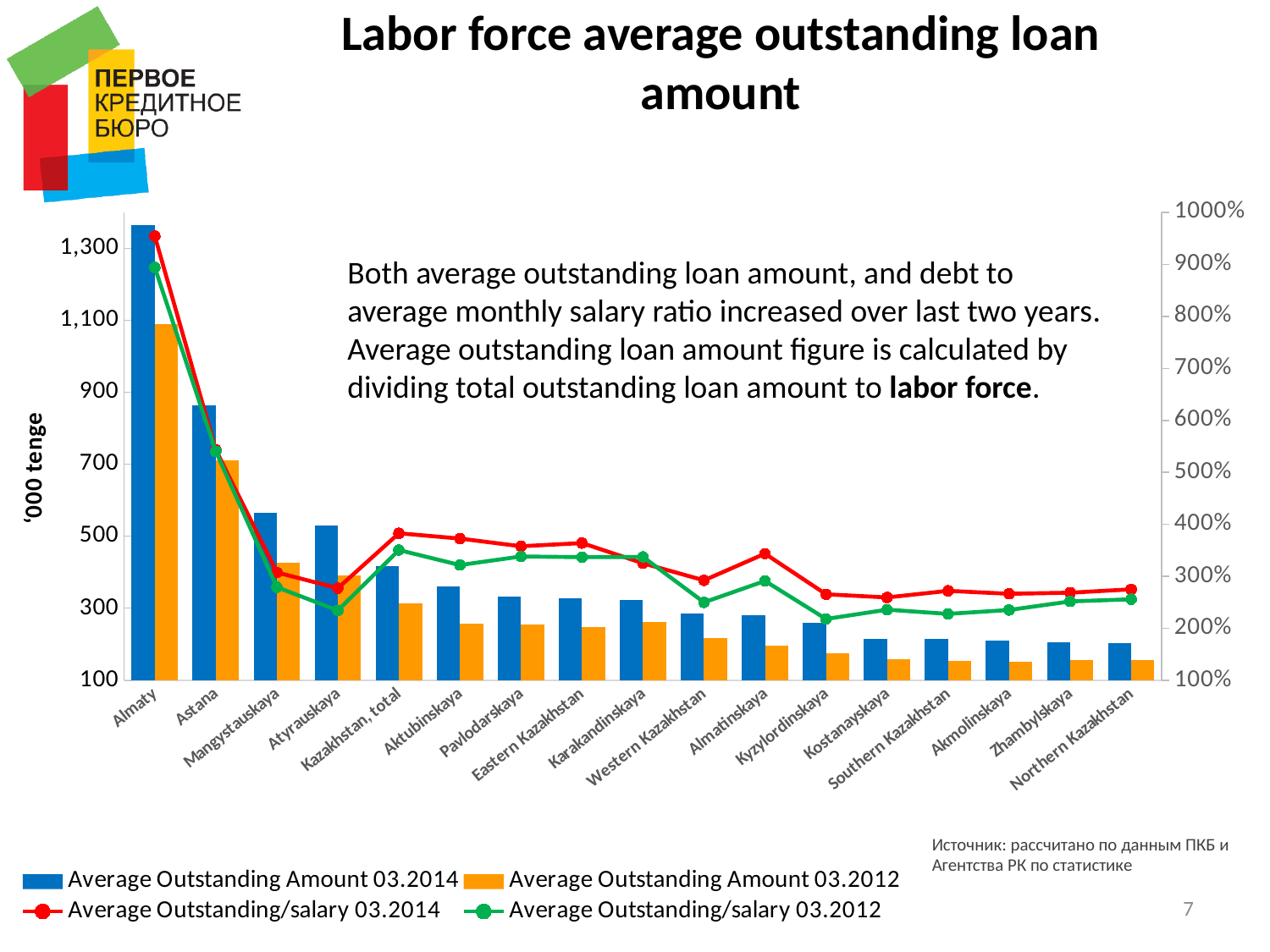
How many regions/categories are shown along the x axis? 17 Do the Average Outstanding Amount 03.2014 bars generally rise or fall from left to right along the x axis? fall Is the Average Outstanding Amount 03.2014 for Astana greater or less than 700? greater Which is larger, the Average Outstanding Amount 03.2014 for Almaty or for Astana? Almaty How many series does the legend list? 4 Is the Average Outstanding Amount 03.2014 for Kazakhstan, total greater or less than 500? less Is the Average Outstanding Amount 03.2014 for Almaty greater or less than 1,300? greater Which category has the highest Average Outstanding Amount 03.2014? Almaty What kind of chart is shown on the slide? A combined bar and line chart What is the label of the left vertical axis? '000 tenge